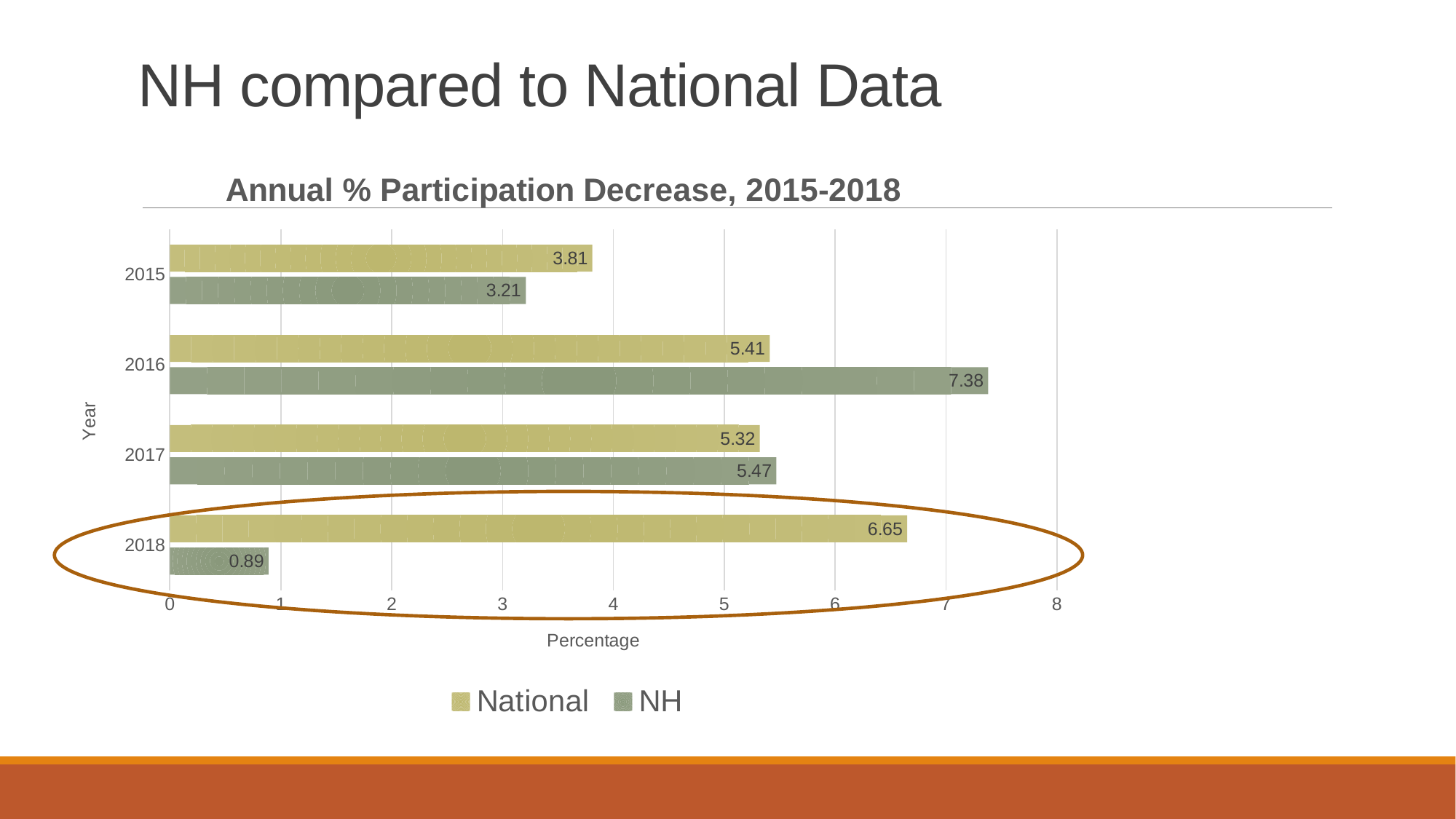
What is the National value for 2018? 6.65 How many years are shown on the chart? 4 Is the NH value for 2016 greater or less than 7? greater What is the difference between the National and NH values for 2018? 5.76 Which year has the lowest National value? 2015 What is the title of the chart? Annual % Participation Decrease, 2015-2018 How many series does the legend list? 2 What kind of chart is shown on the slide? bar chart What is the NH value for 2018? 0.89 Which is larger in 2015, the National value or the NH value? National Which year has the highest NH value? 2016 What is the NH value for 2016? 7.38